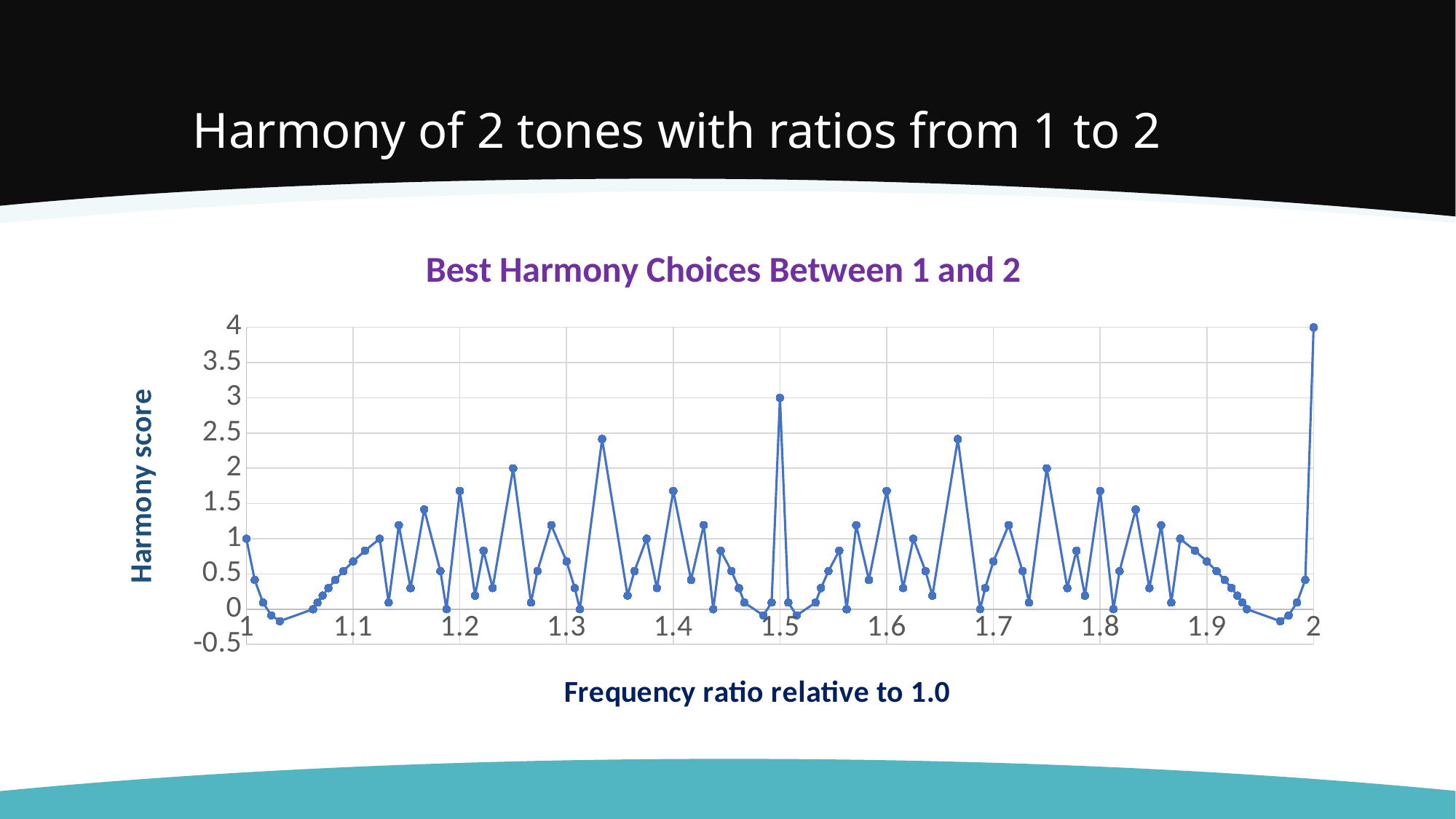
What is the difference between the harmony score at a frequency ratio of 2 and at 1.5? 1 Is the harmony score at a frequency ratio of 1.5 greater or less than 2.5? greater Is the harmony score at a frequency ratio of 1.1 greater or less than 1? less Which has the larger harmony score, a frequency ratio of 2 or 1.5? 2 What kind of chart is shown on the slide? line chart What is the harmony score at a frequency ratio of 1.5? 3 What is the title of the chart? Best Harmony Choices Between 1 and 2 What is the harmony score at a frequency ratio of 1? 1 At which frequency ratio is the harmony score highest? 2 What is the harmony score at a frequency ratio of 2? 4 What is the label of the x axis? Frequency ratio relative to 1.0 Which has the larger harmony score, a frequency ratio of 1.5 or 1.25? 1.5